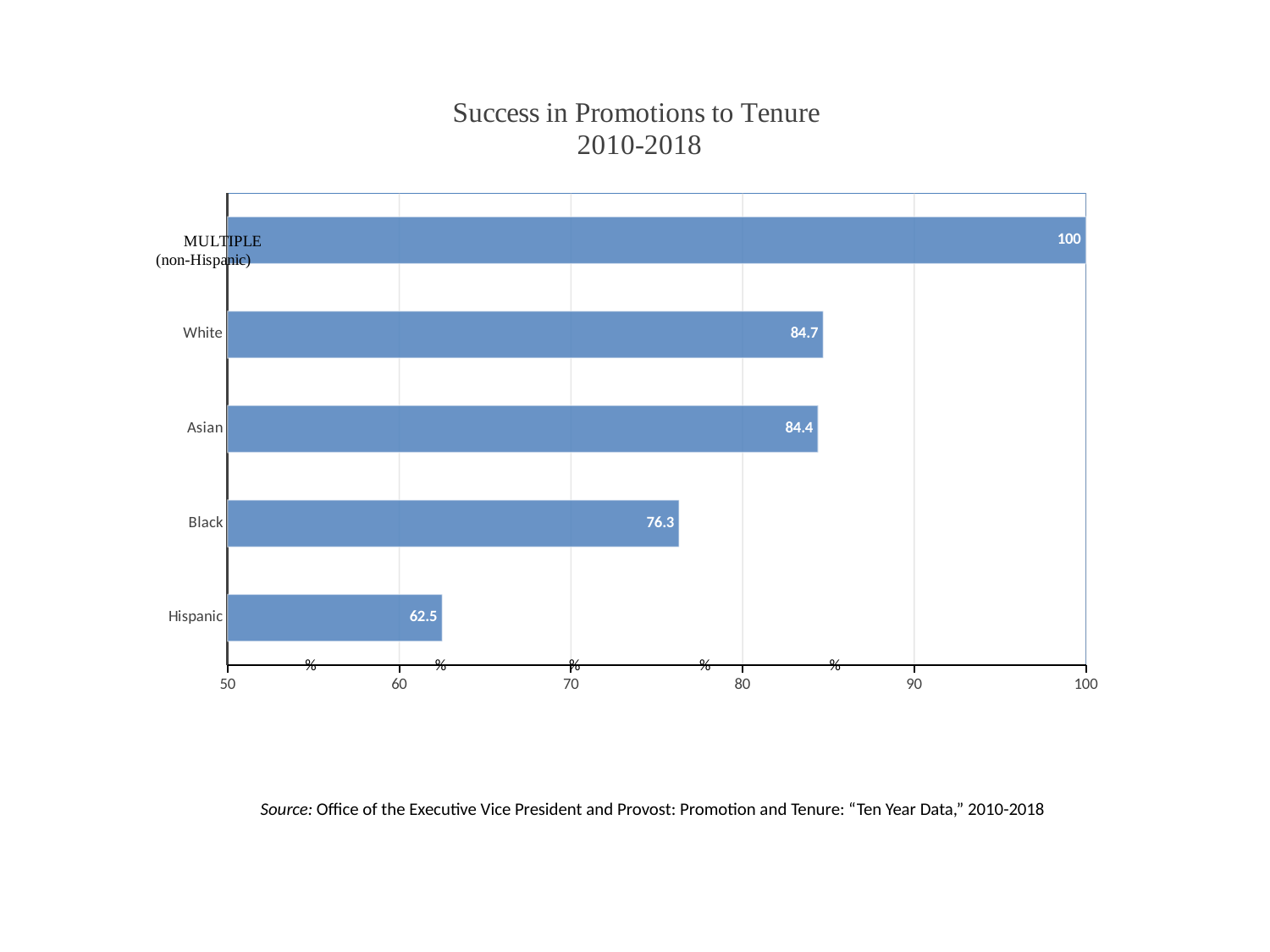
Which category has the lowest value? Hispanic How many categories are shown in the chart? 5 Which category has the highest value? MULTIPLE (non-Hispanic) What is the difference between the values for MULTIPLE (non-Hispanic) and White? 15.3 Which is larger, the value for Black or the value for Hispanic? Black What is the value for Black? 76.3 What is the value for White? 84.7 What kind of chart is shown on the slide? Bar chart What is the value for Hispanic? 62.5 What is the value for MULTIPLE (non-Hispanic)? 100 What is the difference between the values for Black and Hispanic? 13.8 What is the title of the chart? Success in Promotions to Tenure 2010-2018